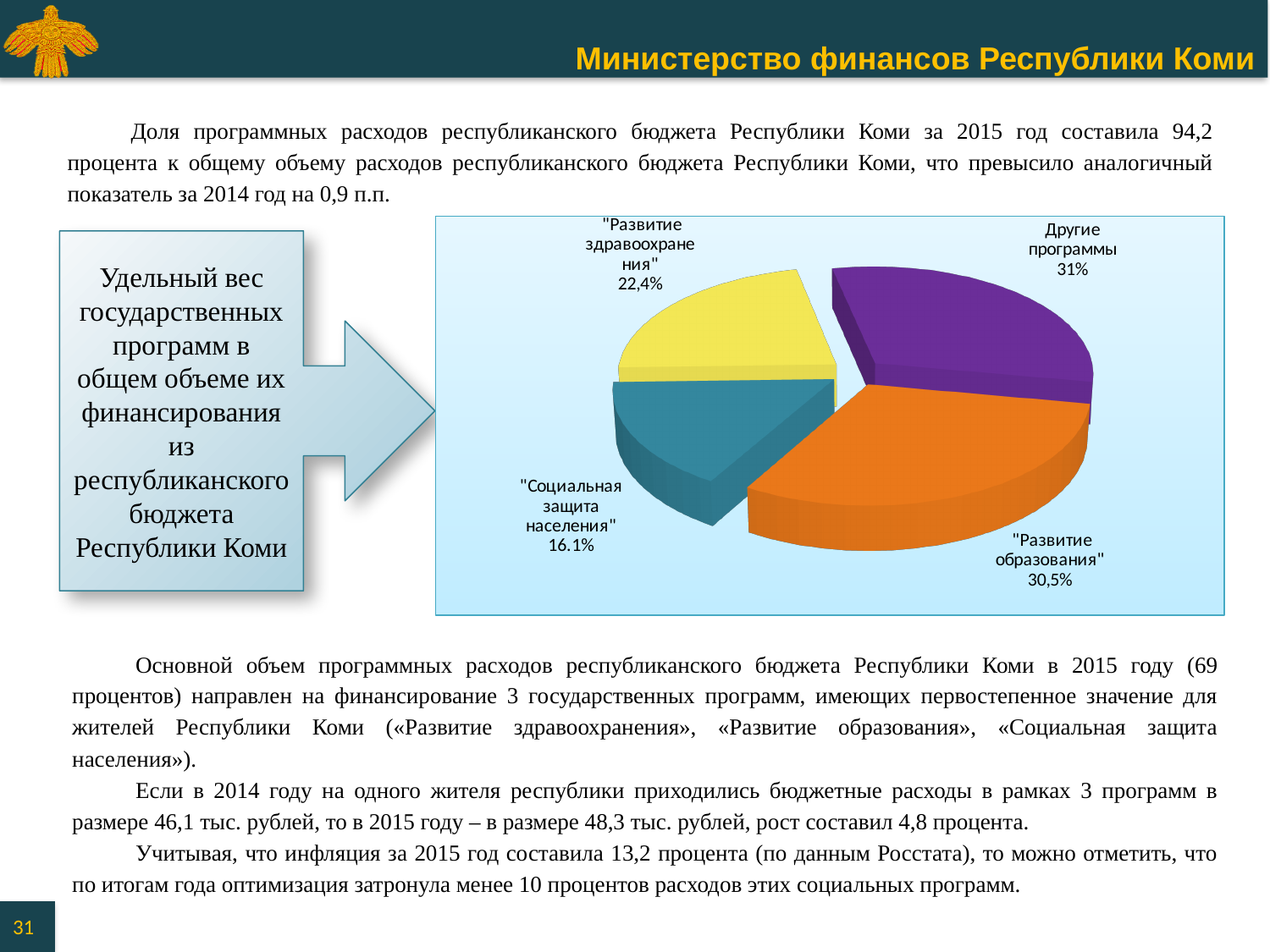
Which slice of the pie chart is the largest? Другие программы What share of the pie does "Развитие здравоохранения" have? 22,4% What is the difference in percentage points between "Развитие здравоохранения" and "Социальная защита населения"? 6,3 percentage points How many slices does the pie chart have? 4 What is the value shown for "Другие программы"? 31% What colour is the "Другие программы" slice in the pie chart? purple Which is larger: the share of "Развитие здравоохранения" or "Социальная защита населения"? Развитие здравоохранения Which slice of the pie chart is the smallest? Социальная защита населения What is the value shown for "Социальная защита населения"? 16.1% What is the value shown for "Развитие образования"? 30,5% What is the combined share of "Развитие здравоохранения", "Развитие образования" and "Социальная защита населения"? 69% What kind of chart is shown on the slide? pie chart